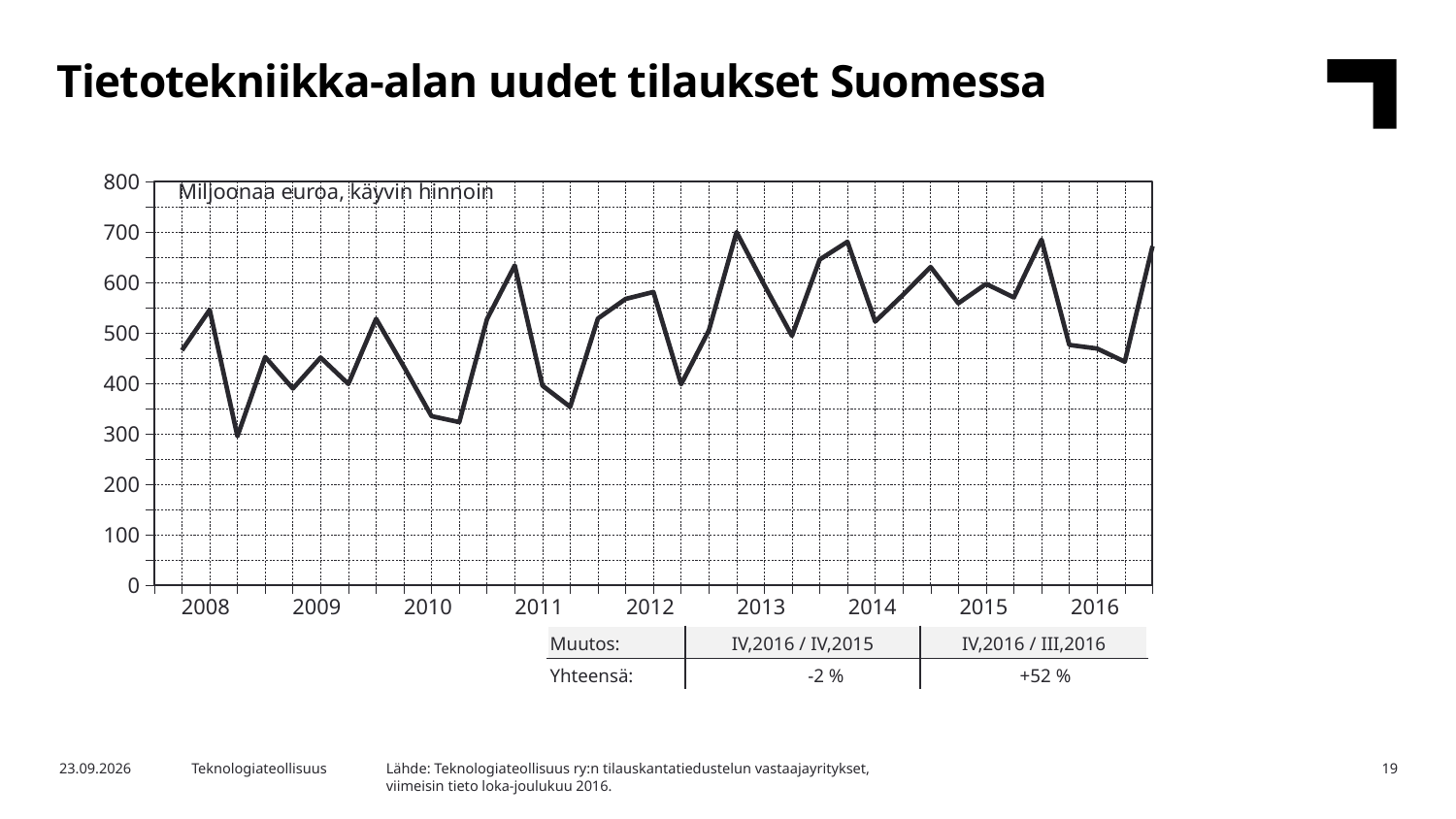
Does the line end in 2016 higher or lower than it starts in 2008? higher What is the change shown for IV,2016 / IV,2015 in the table below the chart? -2 % What is the title of the chart? Tietotekniikka-alan uudet tilaukset Suomessa Is the last point of the line in 2016 greater or less than 600? greater Is the peak of the line in 2013 greater or less than 600? greater Is the lowest point of the line in 2008 greater or less than 400? less In which year does the line reach its lowest point? 2008 What is the change shown for IV,2016 / III,2016 in the table below the chart? +52 % What kind of chart is shown on the slide? line chart What unit is stated inside the chart area? Miljoonaa euroa, käyvin hinnoin How many years are labelled on the x axis? 9